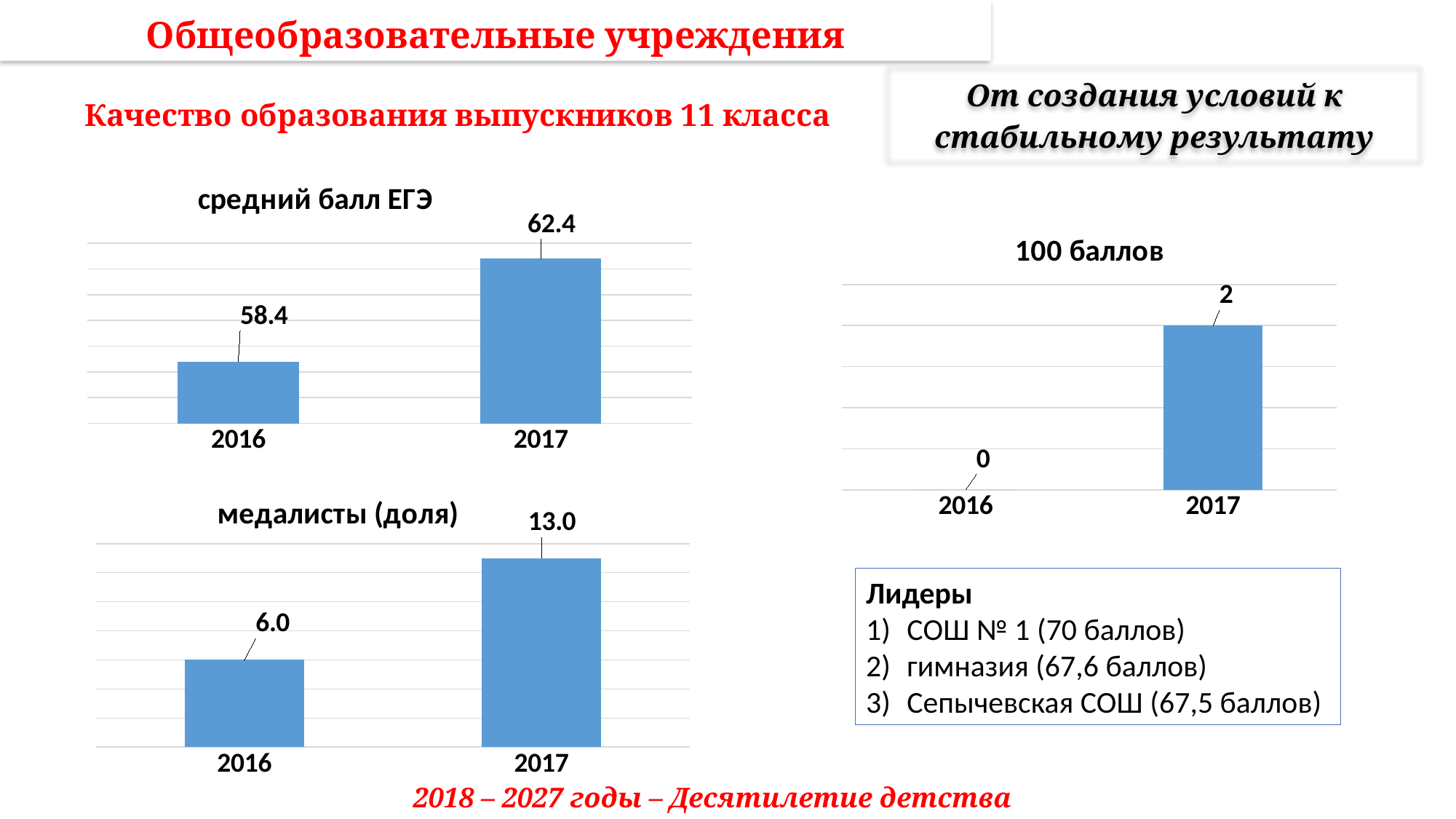
In the chart titled "100 баллов", which year has the higher value? 2017 In the chart titled "средний балл ЕГЭ", do the values rise or fall from 2016 to 2017? rise In the chart titled "средний балл ЕГЭ", by how much did the value increase from 2016 to 2017? 4.0 What type of chart is the chart titled "100 баллов"? bar chart In the chart titled "медалисты (доля)", what is the difference between the 2017 and 2016 values? 7.0 In the chart titled "медалисты (доля)", what is the value for 2016? 6.0 How many categories are shown on the x axis of the chart titled "медалисты (доля)"? 2 In the chart titled "100 баллов", what is the value for 2016? 0 In the chart titled "медалисты (доля)", what is the value for 2017? 13.0 In the chart titled "средний балл ЕГЭ", what is the value for 2017? 62.4 In the chart titled "100 баллов", what is the value for 2017? 2 In the chart titled "средний балл ЕГЭ", what is the value for 2016? 58.4